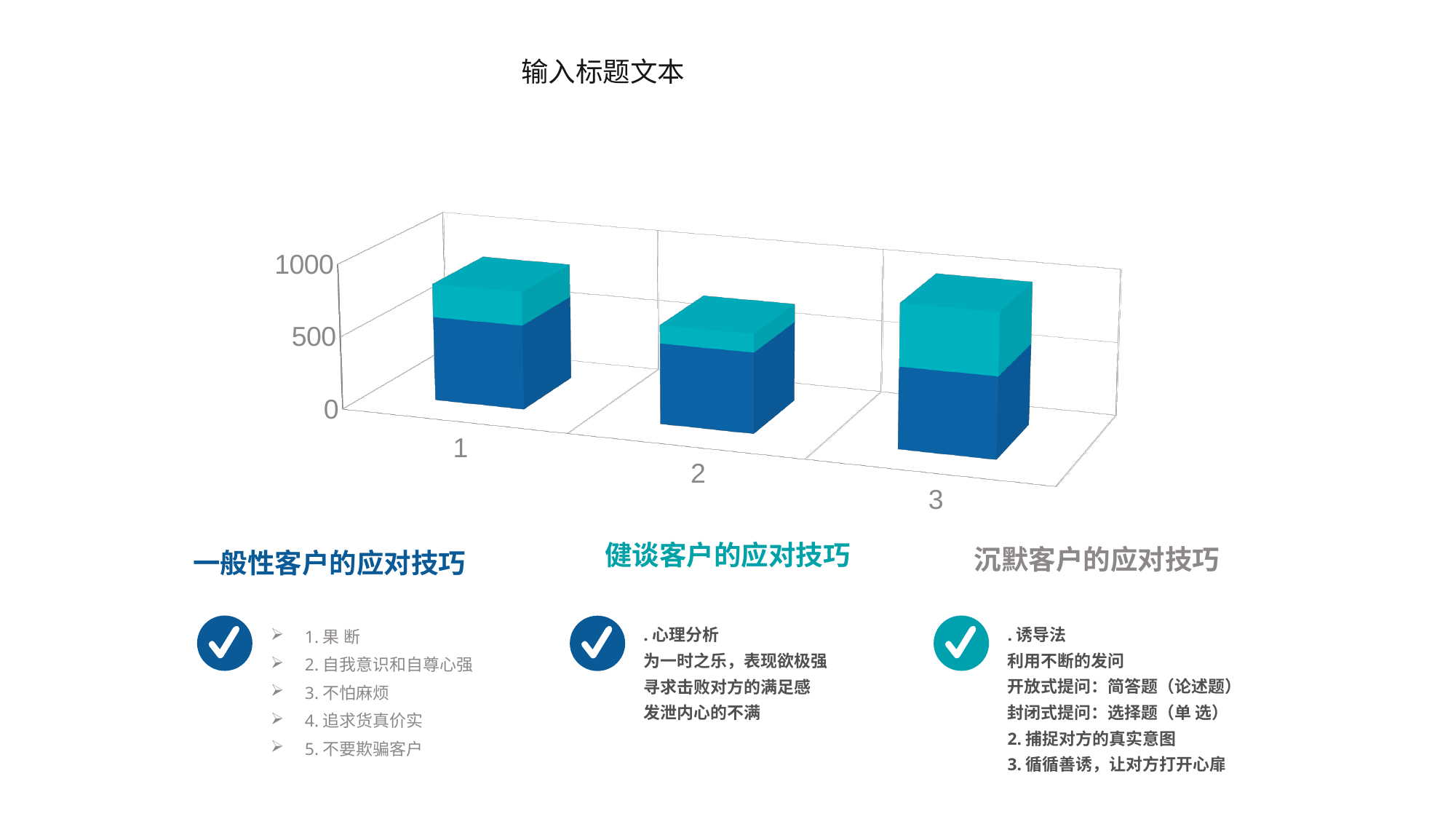
What kind of chart is shown on the slide? Stacked bar chart Is the total stacked bar for category 3 greater or less than 500? greater What is the title shown above the chart? 输入标题文本 Is the total stacked bar for category 2 greater or less than 1000? less Which category has the largest teal (top) segment? 3 What is the highest value labelled on the vertical axis of the chart? 1000 Which category has the tallest stacked bar overall? 3 What are the category labels on the x axis of the chart? 1, 2, 3 How many coloured segments make up each stacked bar? 2 Which category has the shortest stacked bar overall? 2 Which is taller overall, the stacked bar for category 1 or the stacked bar for category 2? Category 1 How many categories are shown on the x axis of the chart? 3